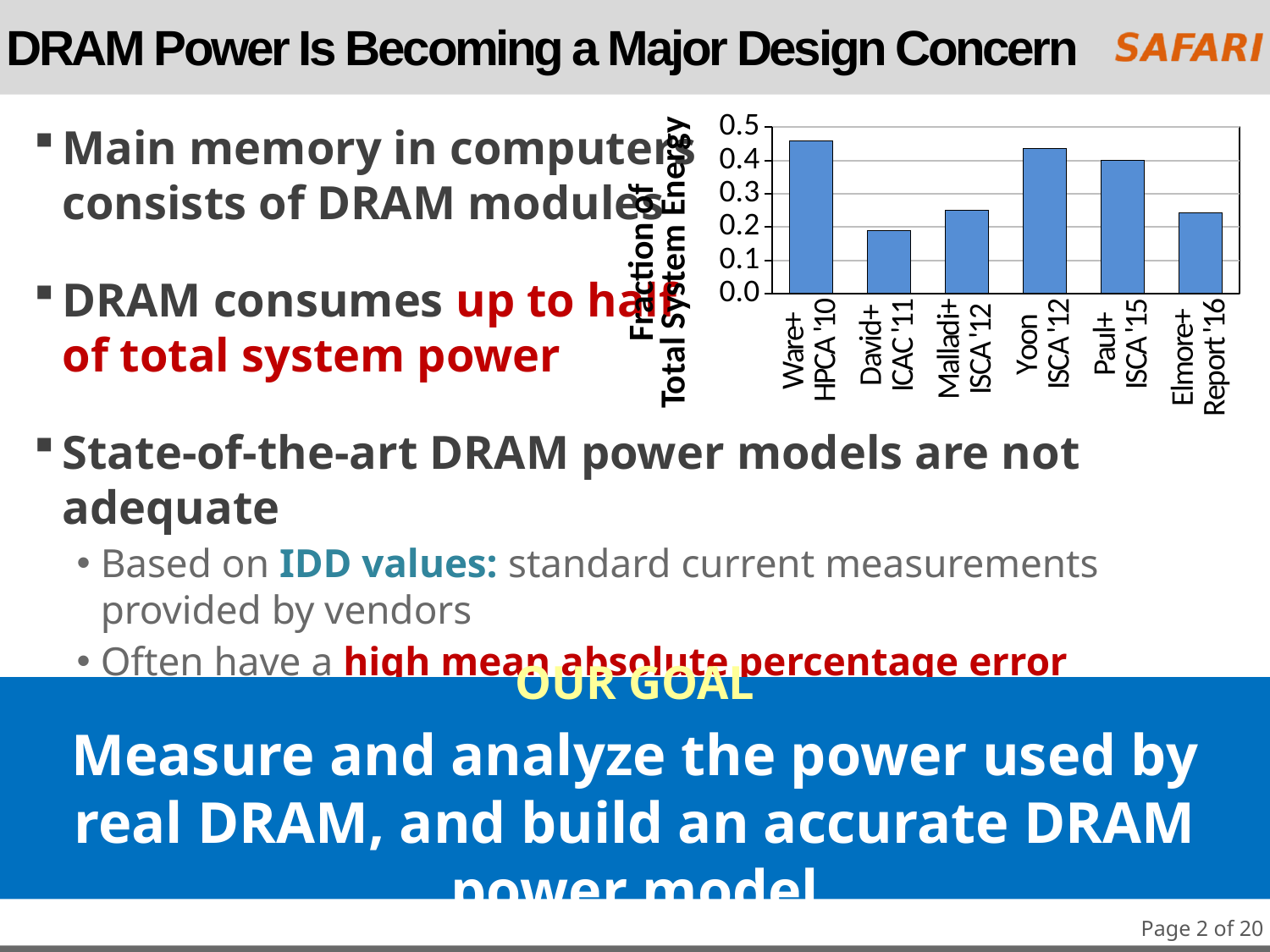
Is the value for Elmore+ Report '16 greater or less than 0.3? less What kind of chart is shown on the slide? bar chart Which category has the lowest fraction of total system energy? David+ ICAC '11 How many bars (categories) does the chart show? 6 What is the label of the chart's vertical axis? Fraction of Total System Energy Is the value for Yoon ISCA '12 greater or less than 0.4? greater Which is larger, the value for Ware+ HPCA '10 or the value for David+ ICAC '11? Ware+ HPCA '10 Is the value for Ware+ HPCA '10 greater or less than 0.4? greater Which is larger, the value for Yoon ISCA '12 or the value for Malladi+ ISCA '12? Yoon ISCA '12